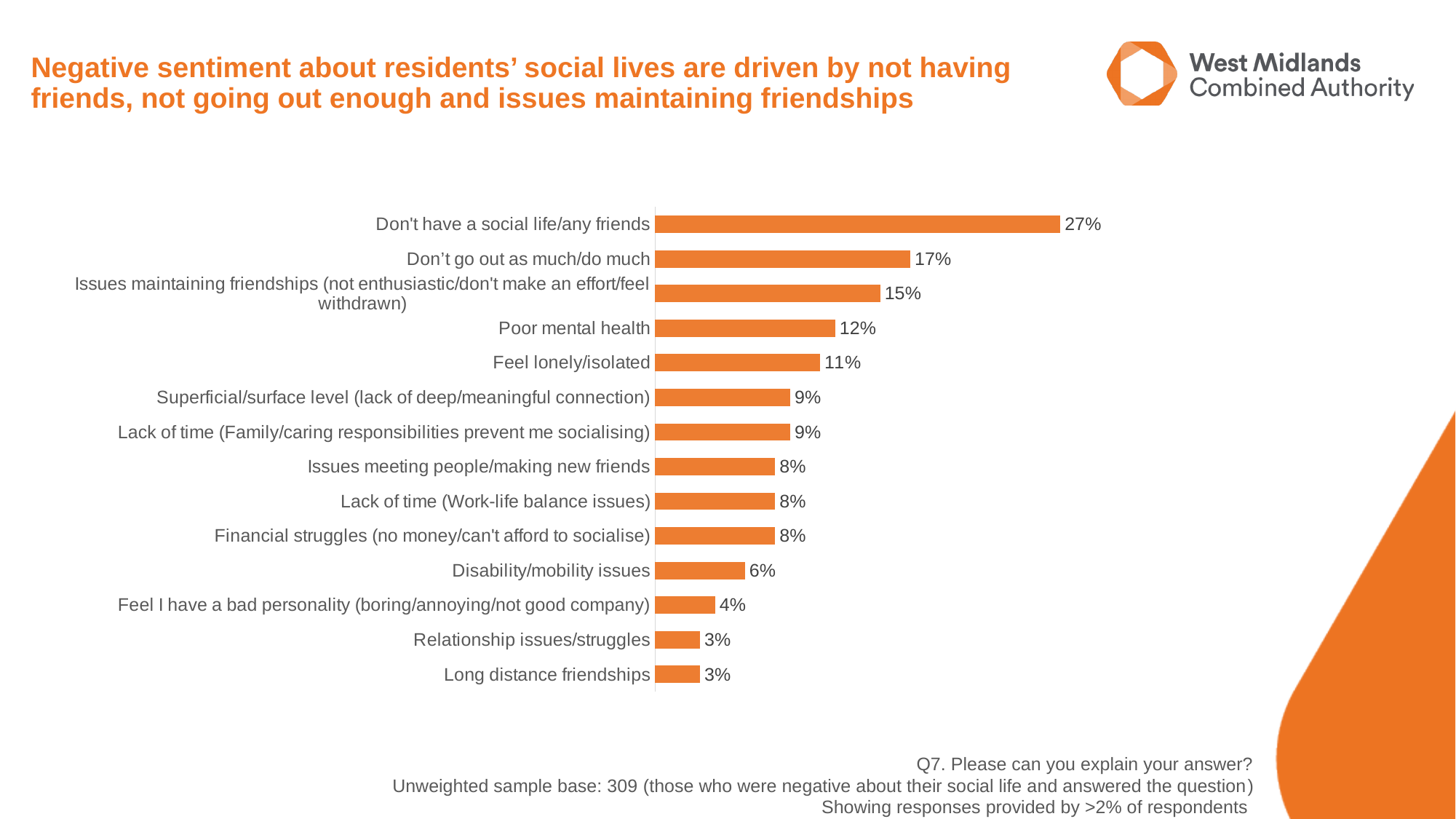
What type of chart is shown on the slide? Bar chart Which is larger: 'Issues maintaining friendships' or 'Feel lonely/isolated'? Issues maintaining friendships What percentage of respondents said they don't have a social life/any friends? 27% What is the unweighted sample base stated on the slide? 309 What is the value for 'Poor mental health'? 12% What is the difference between 'Don't have a social life/any friends' and 'Don't go out as much/do much'? 10% What is the value for 'Feel I have a bad personality (boring/annoying/not good company)'? 4% What is the difference between 'Poor mental health' and 'Feel lonely/isolated'? 1% How many categories are shown in the chart? 14 Which category has the highest value? Don't have a social life/any friends What percentage is shown for 'Disability/mobility issues'? 6% Which is larger: 'Disability/mobility issues' or 'Relationship issues/struggles'? Disability/mobility issues